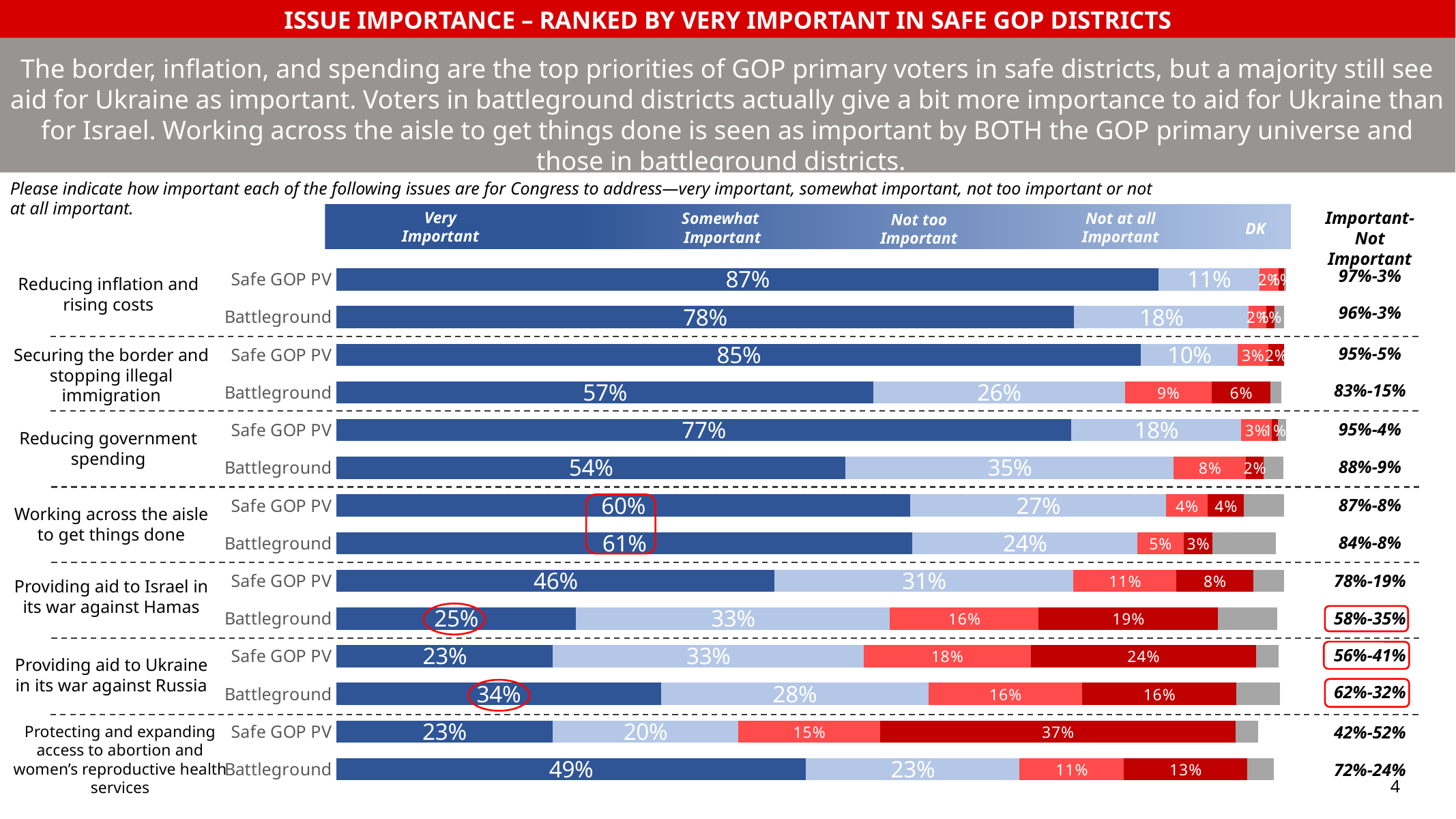
What percentage of Battleground respondents rate 'Securing the border and stopping illegal immigration' as Somewhat Important? 26% How many issues are listed in the chart? 7 Among the Battleground rows, which issue has the lowest Very Important percentage? Providing aid to Israel in its war against Hamas What is the difference in percentage points between the Safe GOP PV and Battleground Very Important values for 'Reducing inflation and rising costs'? 9 percentage points What is the title of the slide? ISSUE IMPORTANCE – RANKED BY VERY IMPORTANT IN SAFE GOP DISTRICTS What kind of chart is shown on the slide? Stacked bar chart How many response categories does the legend list? 5 Which issue and group has the highest Very Important percentage? Reducing inflation and rising costs, Safe GOP PV What percentage of Safe GOP PV respondents rate 'Reducing inflation and rising costs' as Very Important? 87% What percentage of Safe GOP PV respondents rate 'Protecting and expanding access to abortion and women's reproductive health services' as Not at all Important? 37% What is the Important-Not Important figure shown for Battleground respondents on 'Providing aid to Ukraine in its war against Russia'? 62%-32% For 'Providing aid to Ukraine in its war against Russia', which group has the larger Very Important percentage, Safe GOP PV or Battleground? Battleground